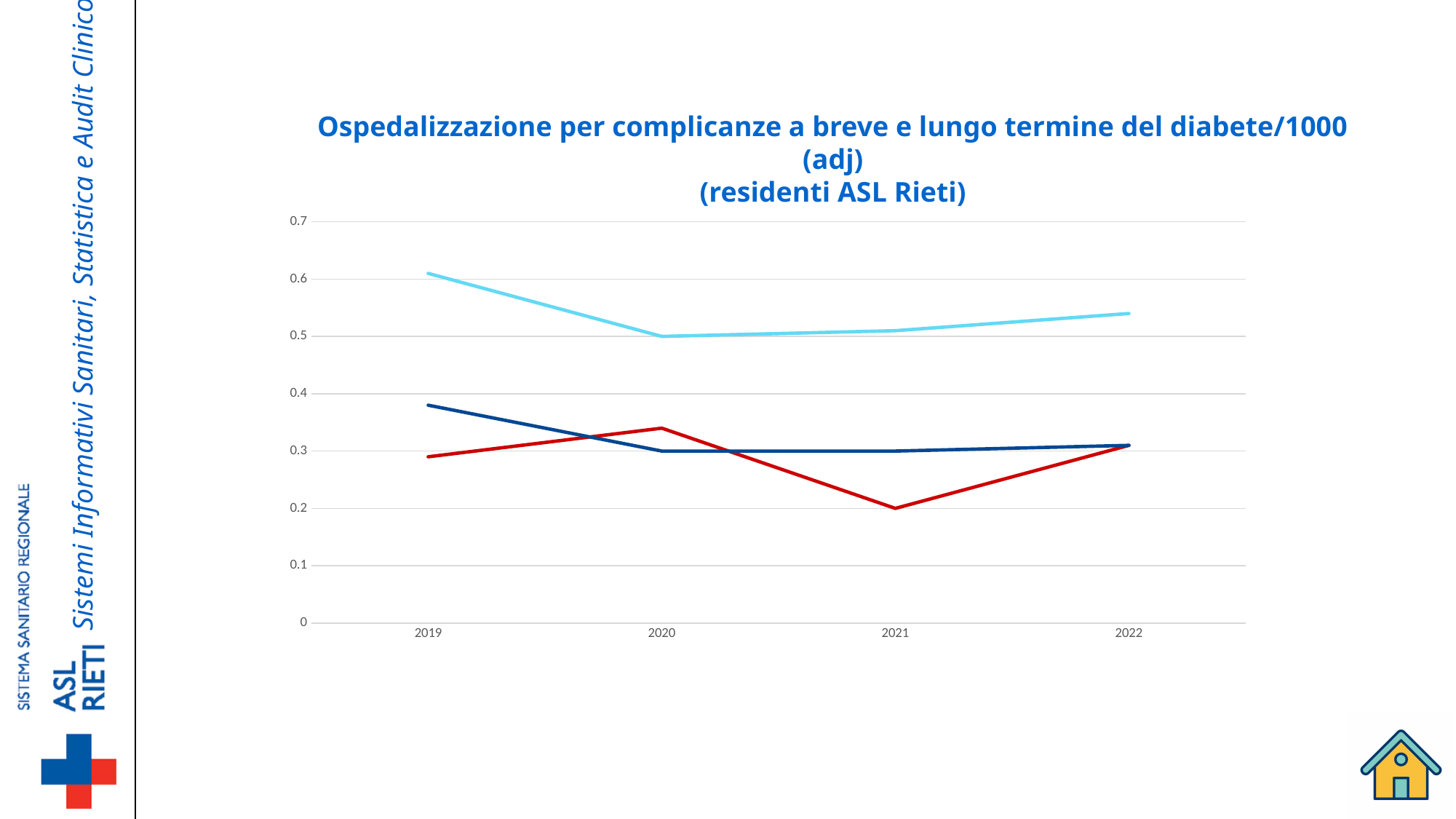
Does the light blue line rise or fall from 2019 to 2020? fall What kind of chart is shown on the slide? line chart How many lines are plotted on the chart? 3 Is the value of the dark blue line in 2019 greater or less than 0.4? less Is the value of the red line in 2020 greater or less than 0.3? greater What is the value of the red line in 2021? 0.2 How many years are shown on the x axis of the chart? 4 Which year has the lowest value for the red line? 2021 Which line is highest across all years shown? light blue line In 2019, which line has the higher value, the dark blue line or the red line? dark blue line Which year has the highest value for the light blue line? 2019